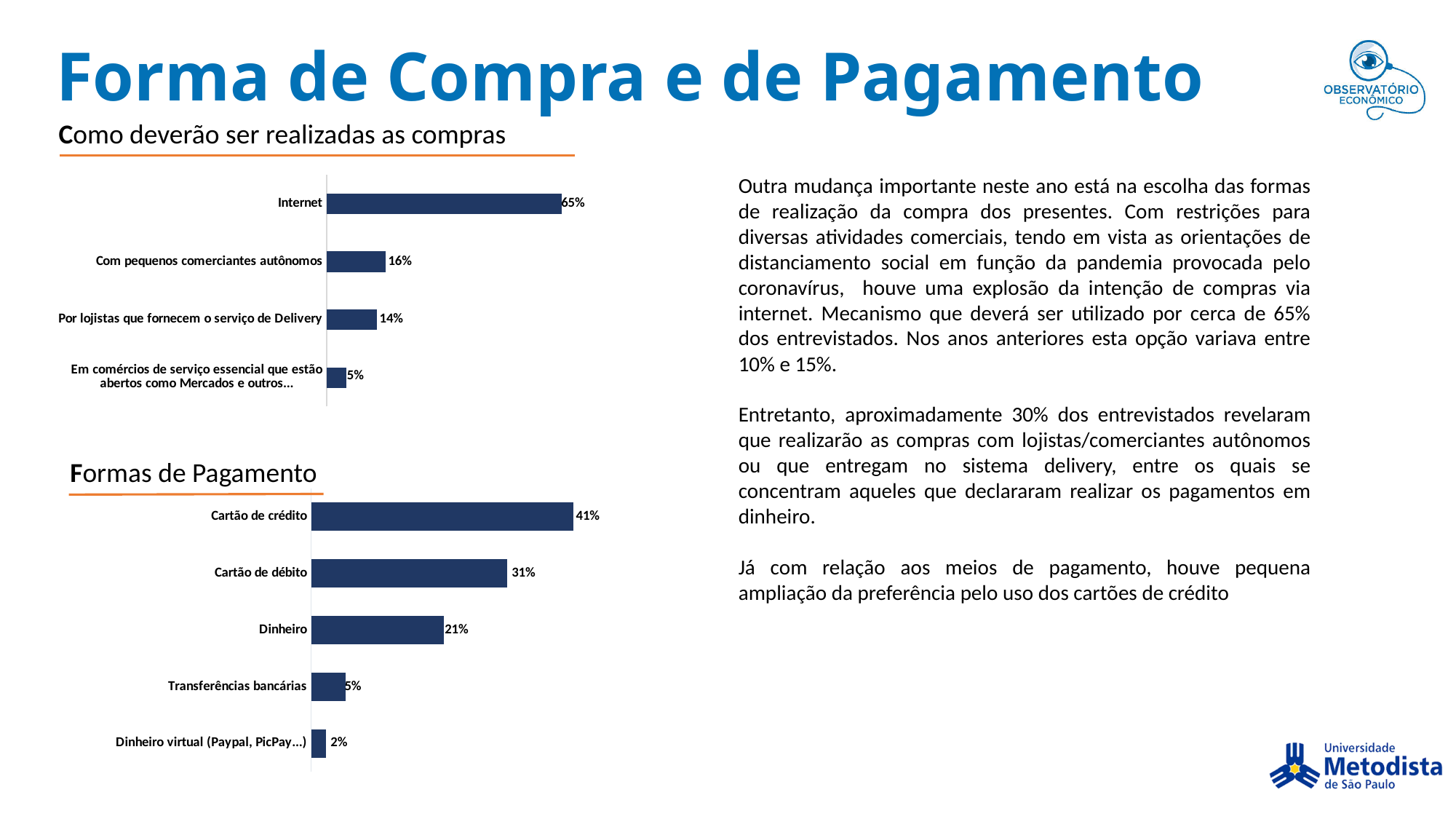
In the 'Formas de Pagamento' chart, what is the value for Cartão de débito? 31% In the 'Como deverão ser realizadas as compras' chart, what is the difference between Internet and 'Com pequenos comerciantes autônomos'? 49% In the 'Formas de Pagamento' chart, which category has the highest value? Cartão de crédito In the 'Formas de Pagamento' chart, which is larger: Dinheiro or Transferências bancárias? Dinheiro In the 'Formas de Pagamento' chart, what is the difference between Cartão de crédito and Cartão de débito? 10% In the 'Formas de Pagamento' chart, what is the value for Dinheiro virtual (Paypal, PicPay...)? 2% In the 'Como deverão ser realizadas as compras' chart, what is the value for 'Por lojistas que fornecem o serviço de Delivery'? 14% In the 'Como deverão ser realizadas as compras' chart, which category has the lowest value? Em comércios de serviço essencial que estão abertos como Mercados e outros... In the 'Formas de Pagamento' chart, how many categories are shown? 5 In the 'Como deverão ser realizadas as compras' chart, how many categories are shown? 4 What type of chart is the 'Formas de Pagamento' chart? Bar chart In the 'Como deverão ser realizadas as compras' chart, what is the value for Internet? 65%